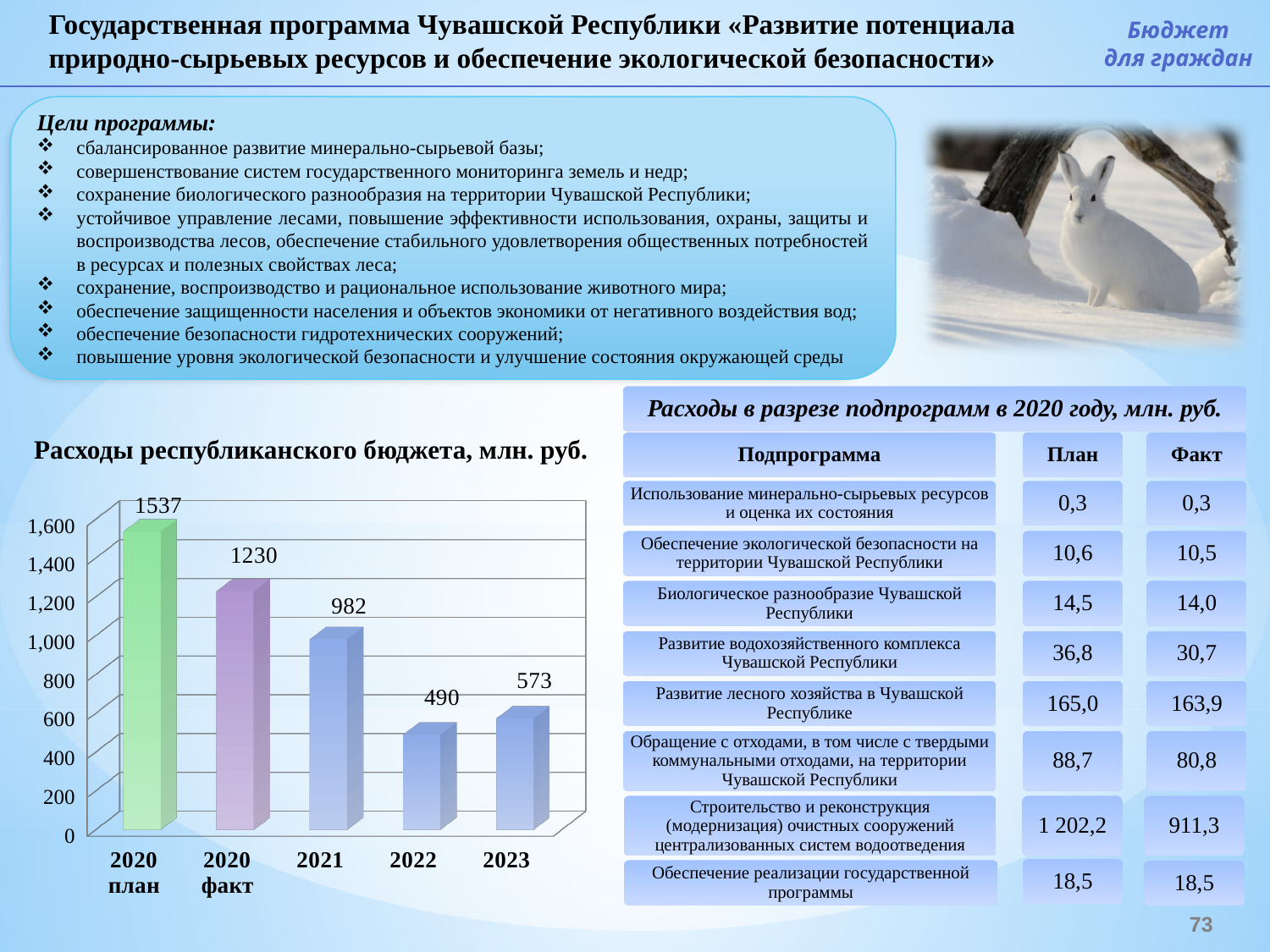
What is the value for 2020 план in the chart "Расходы республиканского бюджета, млн. руб."? 1537 What is the difference between the 2020 план and 2020 факт values in the chart "Расходы республиканского бюджета, млн. руб."? 307 What kind of chart is "Расходы республиканского бюджета, млн. руб."? bar chart Is the value for 2020 факт greater or less than 1,200 in the chart "Расходы республиканского бюджета, млн. руб."? greater How many categories are shown in the chart "Расходы республиканского бюджета, млн. руб."? 5 What is the value for 2023 in the chart "Расходы республиканского бюджета, млн. руб."? 573 Do the values rise or fall from 2020 факт to 2022 in the chart "Расходы республиканского бюджета, млн. руб."? fall What is the difference between the 2023 and 2022 values in the chart "Расходы республиканского бюджета, млн. руб."? 83 Which category has the lowest value in the chart "Расходы республиканского бюджета, млн. руб."? 2022 Which is larger in the chart "Расходы республиканского бюджета, млн. руб.": the value for 2021 or the value for 2023? 2021 Which category has the highest value in the chart "Расходы республиканского бюджета, млн. руб."? 2020 план What is the value for 2021 in the chart "Расходы республиканского бюджета, млн. руб."? 982